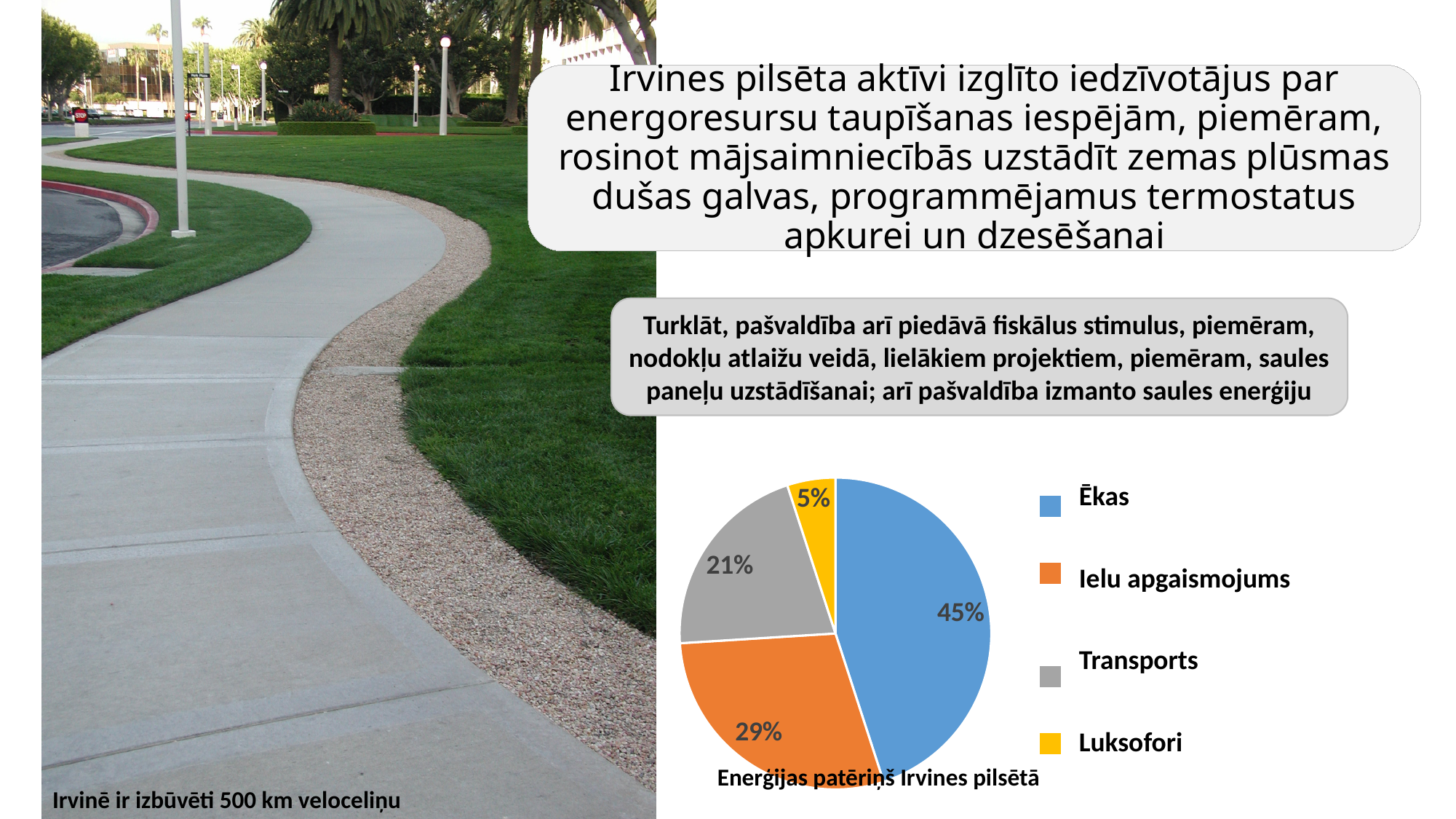
Which category has the largest share of the pie? Ēkas Which category has the smallest share of the pie? Luksofori Which is larger, the share for Transports or the share for Ielu apgaismojums? Ielu apgaismojums What colour is the slice for Transports? grey What share of the pie does Ēkas have? 45% What share of the pie does Luksofori have? 5% What is the title of the chart? Enerģijas patēriņš Irvines pilsētā What kind of chart is shown on the slide? pie chart How many categories does the pie chart have? 4 What share of the pie does Ielu apgaismojums have? 29% What is the difference between the shares of Ēkas and Ielu apgaismojums? 16% What share of the pie does Transports have? 21%